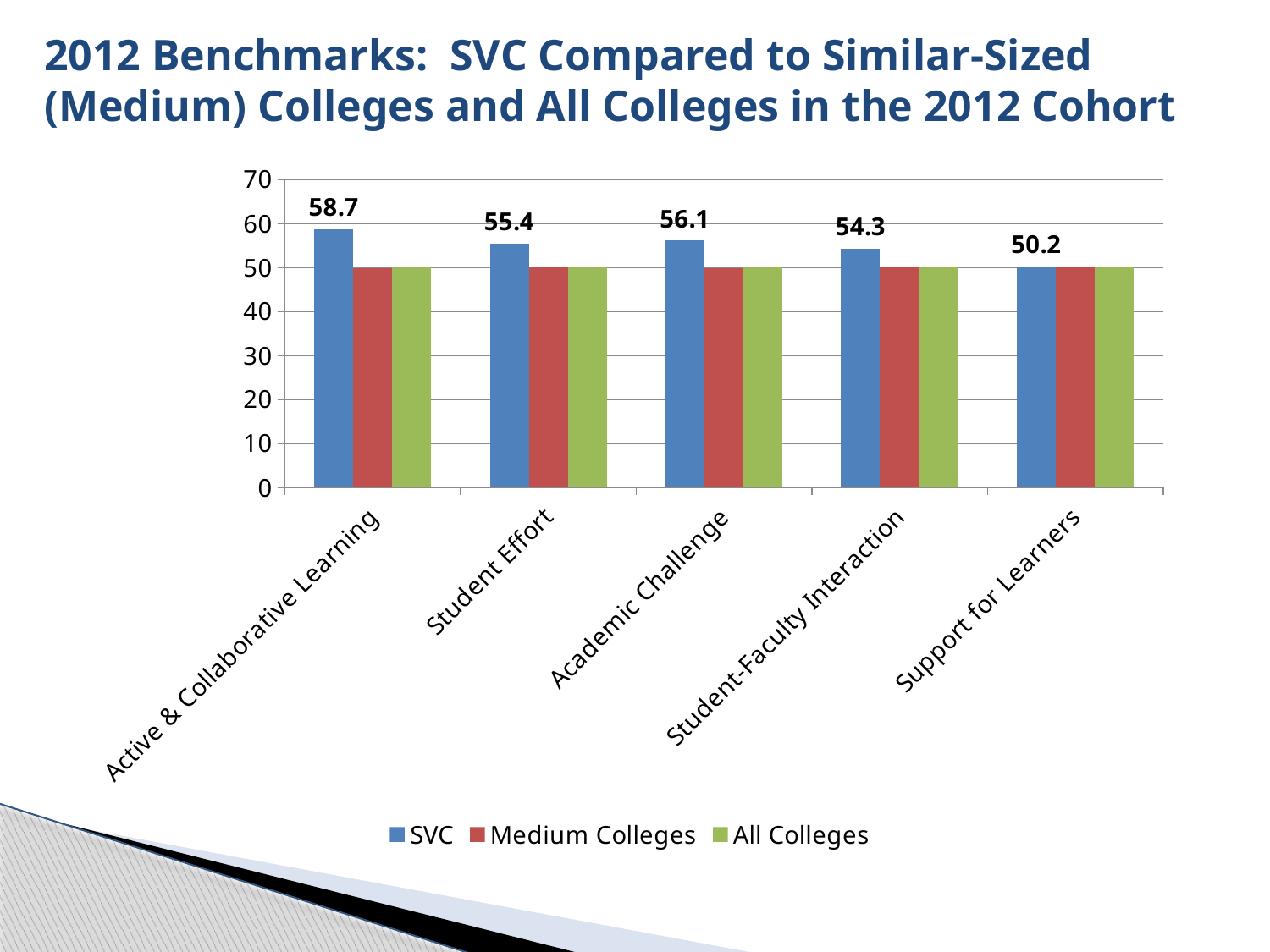
What is the SVC value for Student-Faculty Interaction? 54.3 Is the Medium Colleges value for Student Effort greater or less than 40? greater Which benchmark has the highest SVC value? Active & Collaborative Learning What is the SVC value for Support for Learners? 50.2 What is the difference between the SVC values for Active & Collaborative Learning and Student Effort? 3.3 Which benchmark has the lowest SVC value? Support for Learners How many series does the legend list? 3 What kind of chart is shown on the slide? bar chart What is the difference between the SVC values for Academic Challenge and Student-Faculty Interaction? 1.8 How many benchmark categories are shown on the x axis? 5 What is the SVC value for Active & Collaborative Learning? 58.7 Which is larger, the SVC value for Student Effort or for Academic Challenge? Academic Challenge